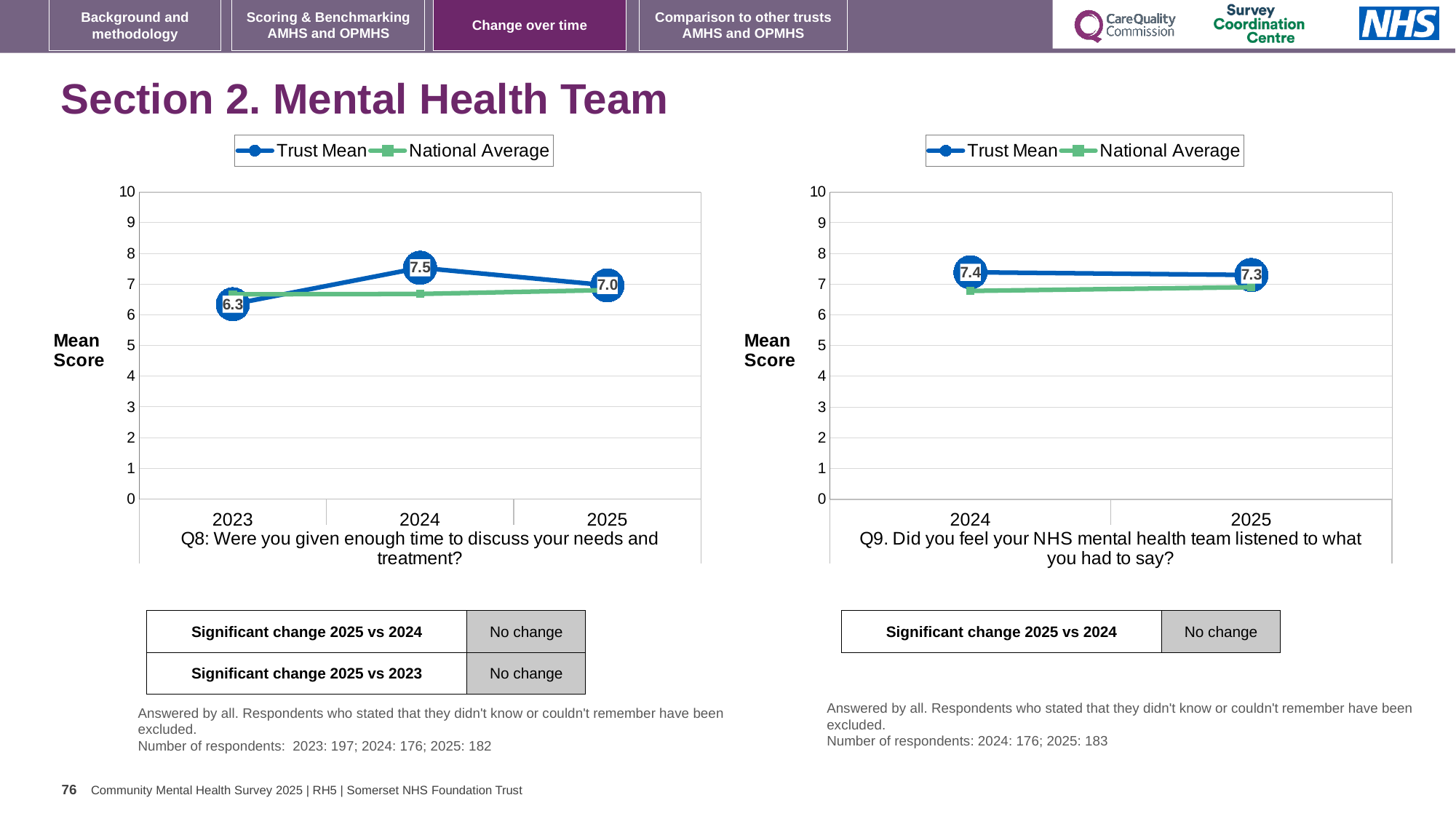
In the Q9 chart (right), what is the difference between the Trust Mean for 2024 and 2025? 0.1 In the Q8 chart (left), what is the difference between the Trust Mean for 2024 and 2023? 1.2 In the Q8 chart (left), is the National Average for 2023 greater or less than 5? greater How many series does the legend of the Q8 chart (left) list? 2 How many years are plotted on the x axis of the Q9 chart (right)? 2 In the Q8 chart (left), what is the Trust Mean for 2023? 6.3 In the Q9 chart (right), what is the Trust Mean for 2025? 7.3 What kind of chart is the Q9 chart (right)? line chart In the Q8 chart (left), is the Trust Mean for 2025 larger or smaller than the Trust Mean for 2023? larger In the Q8 chart (left), what is the Trust Mean for 2024? 7.5 In the Q8 chart (left), which year has the lowest Trust Mean? 2023 In the Q8 chart (left), which year has the highest Trust Mean? 2024